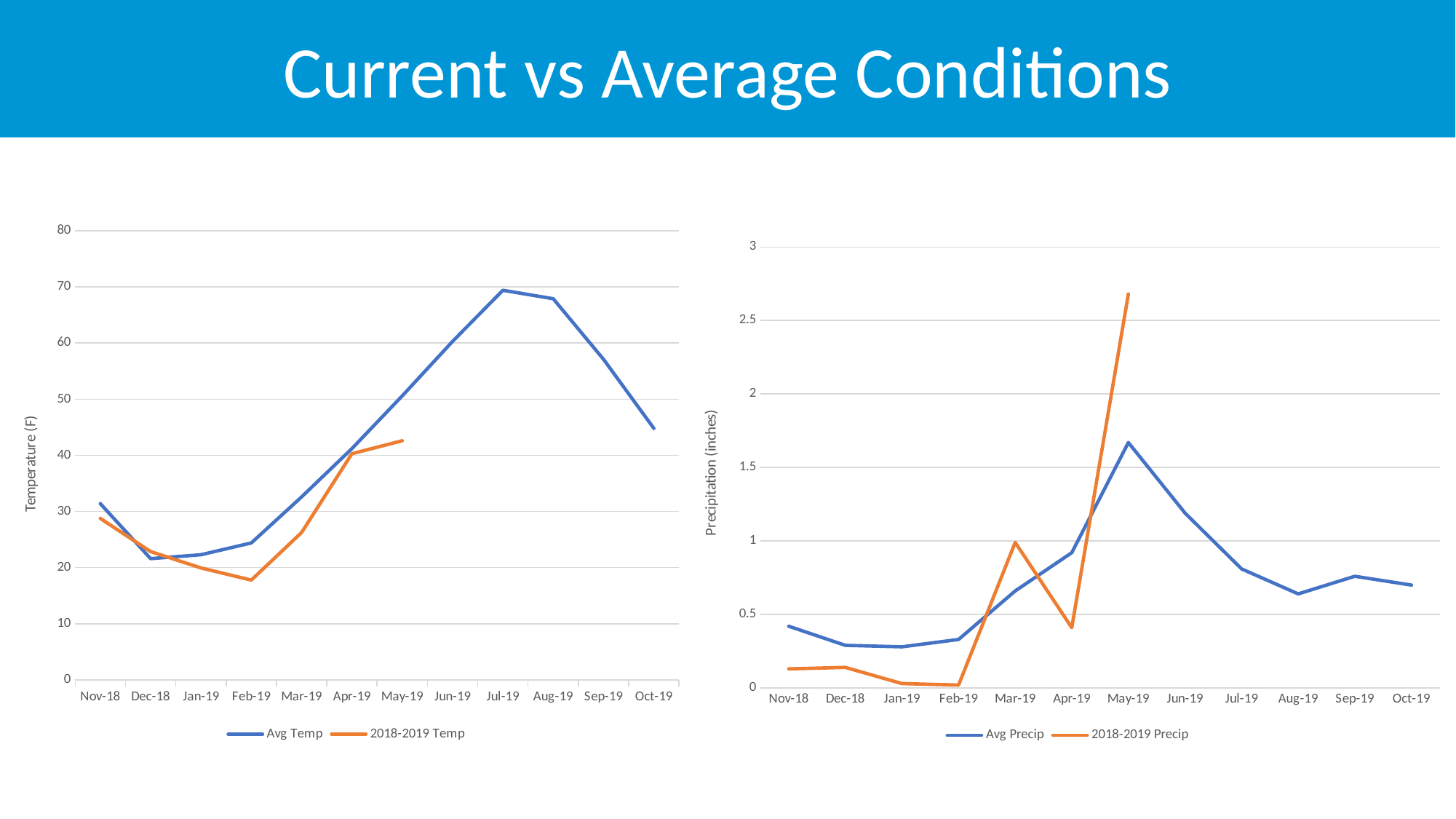
What is the y-axis label of the right chart? Precipitation (inches) In the left chart (Temperature), is the 2018-2019 Temp for Feb-19 greater or less than 20? less In the left chart (Temperature), is the Avg Temp for Jul-19 greater or less than 60? greater In the left chart (Temperature), which month has the highest Avg Temp? Jul-19 How many months are shown on the x axis of the left chart (Temperature)? 12 What kind of chart is the left chart (Temperature)? line chart In the right chart (Precipitation), which month has the highest 2018-2019 Precip? May-19 In the left chart (Temperature), does the Avg Temp rise or fall from Jul-19 to Oct-19? fall In the right chart (Precipitation), is the 2018-2019 Precip for May-19 greater or less than 2.5? greater In the right chart (Precipitation), which is larger for Apr-19: Avg Precip or 2018-2019 Precip? Avg Precip How many series does the legend of the right chart (Precipitation) list? 2 In the left chart (Temperature), which month has the lowest 2018-2019 Temp? Feb-19